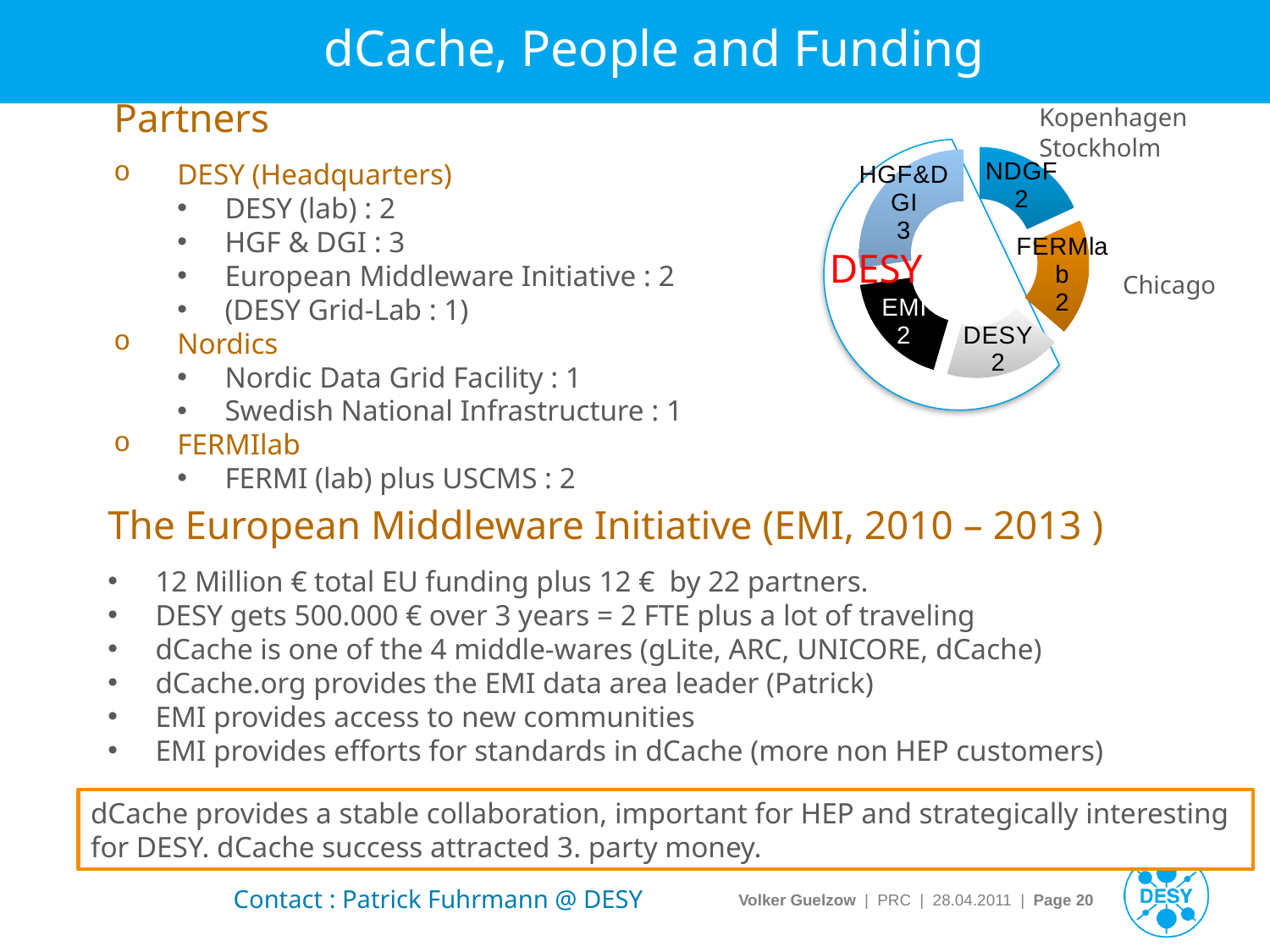
What is the value shown for the DESY segment? 2 What kind of chart is shown on the slide? doughnut (pie) chart What is the difference between the HGF&DGI value and the EMI value? 1 Which city label is placed next to the FERMIlab segment? Chicago Which is larger, the HGF&DGI segment or the NDGF segment? HGF&DGI What is the value shown for the FERMIlab segment? 2 What is the value shown for the EMI segment? 2 How many segments does the chart have? 5 Which segment has the highest value? HGF&DGI What is the value shown for the HGF&DGI segment? 3 What is the total of all segment values in the chart? 11 What is the value shown for the NDGF segment? 2